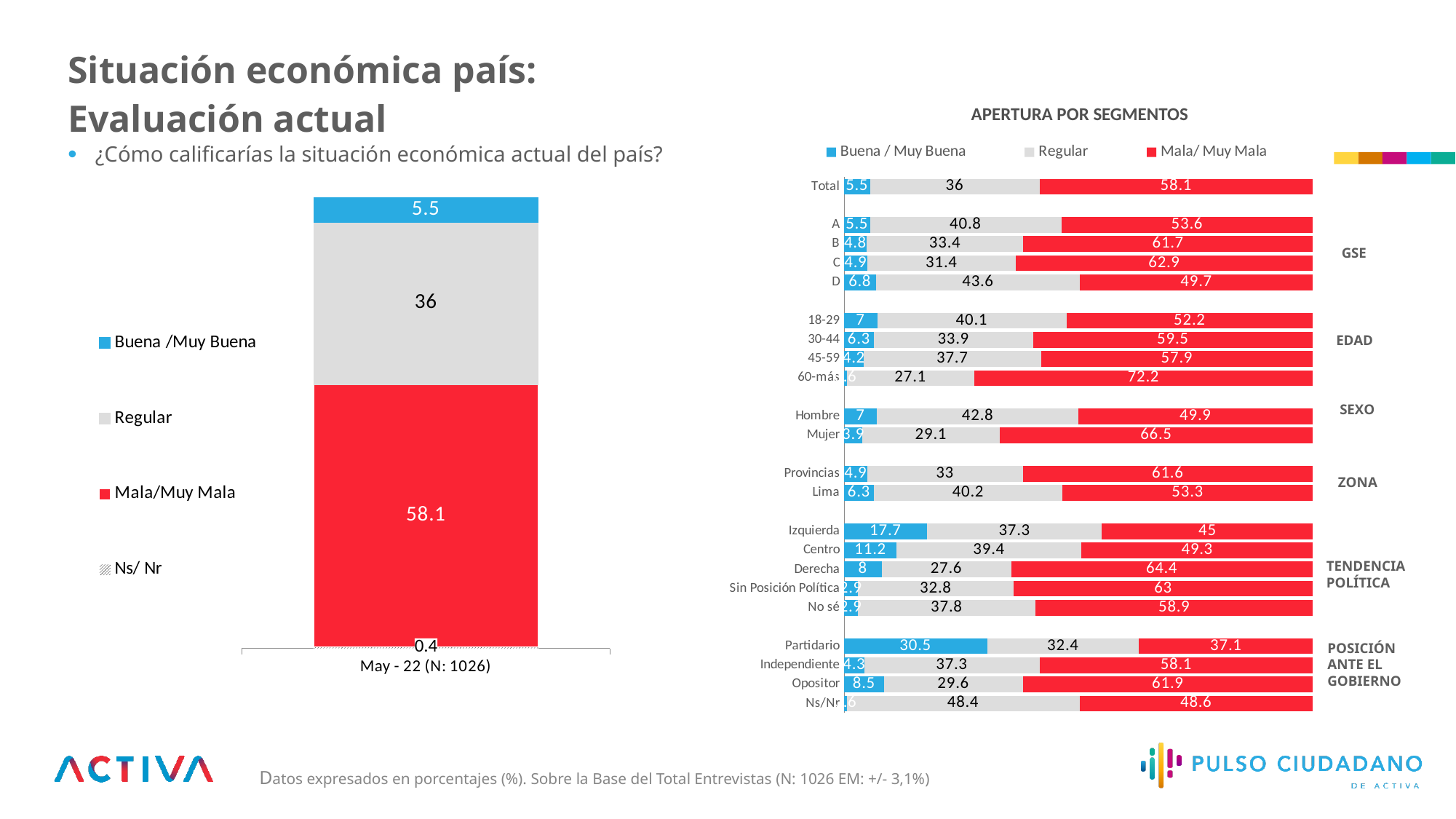
In the APERTURA POR SEGMENTOS chart, which segment has the highest Buena / Muy Buena value? Partidario In the left stacked bar chart, what is the value for Mala/Muy Mala? 58.1 In the APERTURA POR SEGMENTOS chart, what is the difference between the Mala/Muy Mala values for Mujer and Hombre? 16.6 In the APERTURA POR SEGMENTOS chart, how many series does the legend list? 3 In the APERTURA POR SEGMENTOS chart, which segment has the highest Mala/Muy Mala value? 60-más In the APERTURA POR SEGMENTOS chart, what is the Buena / Muy Buena value for Partidario? 30.5 What kind of chart is the left chart labelled May - 22 (N: 1026)? Stacked bar chart In the APERTURA POR SEGMENTOS chart, what is the Mala/Muy Mala value for 60-más? 72.2 In the left stacked bar chart, what is the value for Regular? 36 In the APERTURA POR SEGMENTOS chart, which has the larger Regular value, Lima or Provincias? Lima In the left stacked bar chart, how many series does the legend list? 4 In the APERTURA POR SEGMENTOS chart, what is the Regular value for Ns/Nr under POSICIÓN ANTE EL GOBIERNO? 48.4